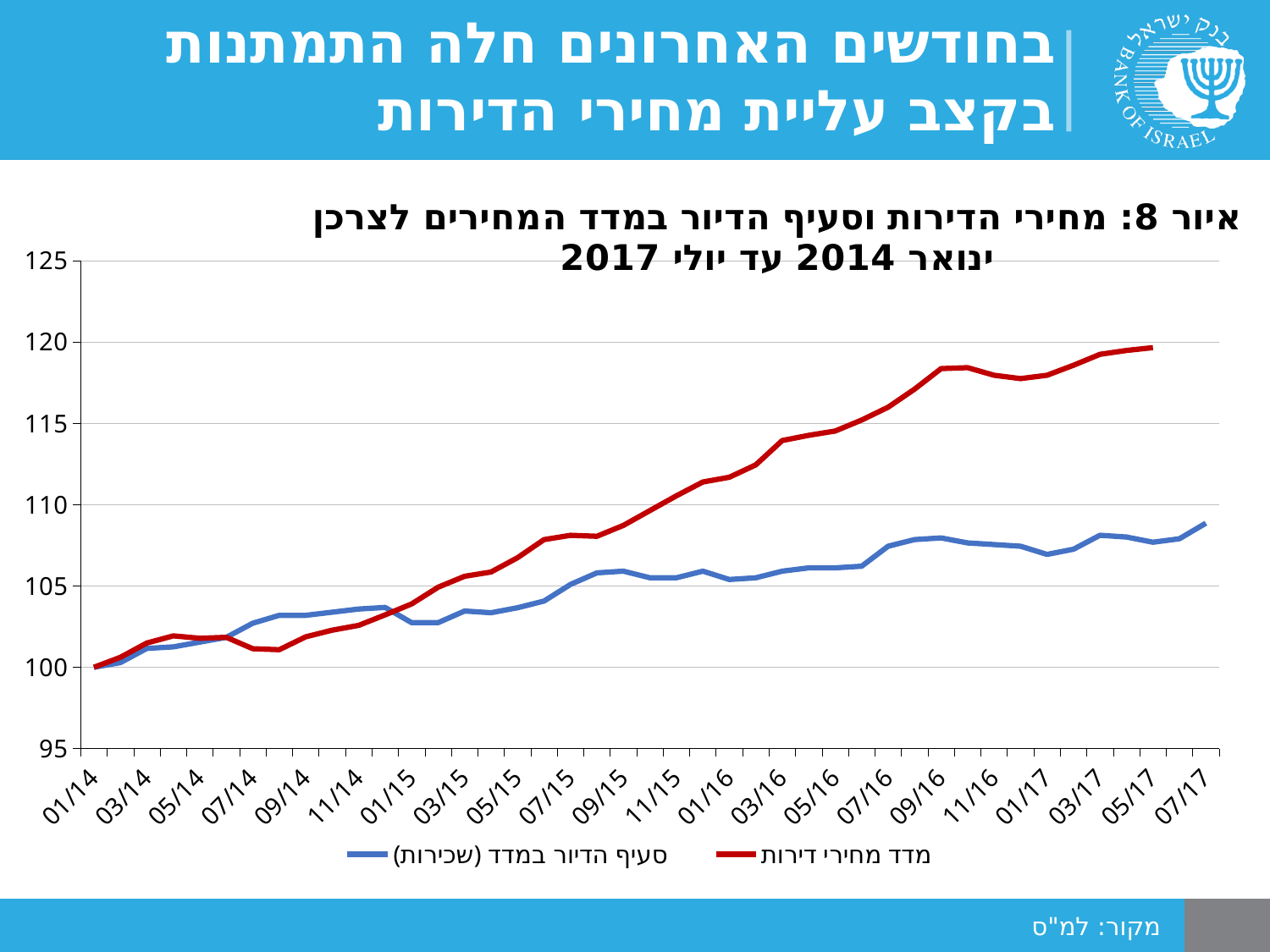
Is the value of מדד מחירי דירות at 09/14 greater or less than 105? less What is the source cited at the bottom of the slide? למ"ס What is the value of מדד מחירי דירות at 01/14? 100 Is the value of מדד מחירי דירות at 05/17 greater or less than 115? greater Is the value of סעיף הדיור במדד (שכירות) at 07/17 greater or less than 110? less Which series is drawn in red? מדד מחירי דירות How many series does the legend list? 2 At 09/14, which series has the higher value, מדד מחירי דירות or סעיף הדיור במדד (שכירות)? סעיף הדיור במדד (שכירות) Does the סעיף הדיור במדד (שכירות) series rise or fall overall from 01/14 to 07/17? rise What kind of chart is shown on the slide? line chart